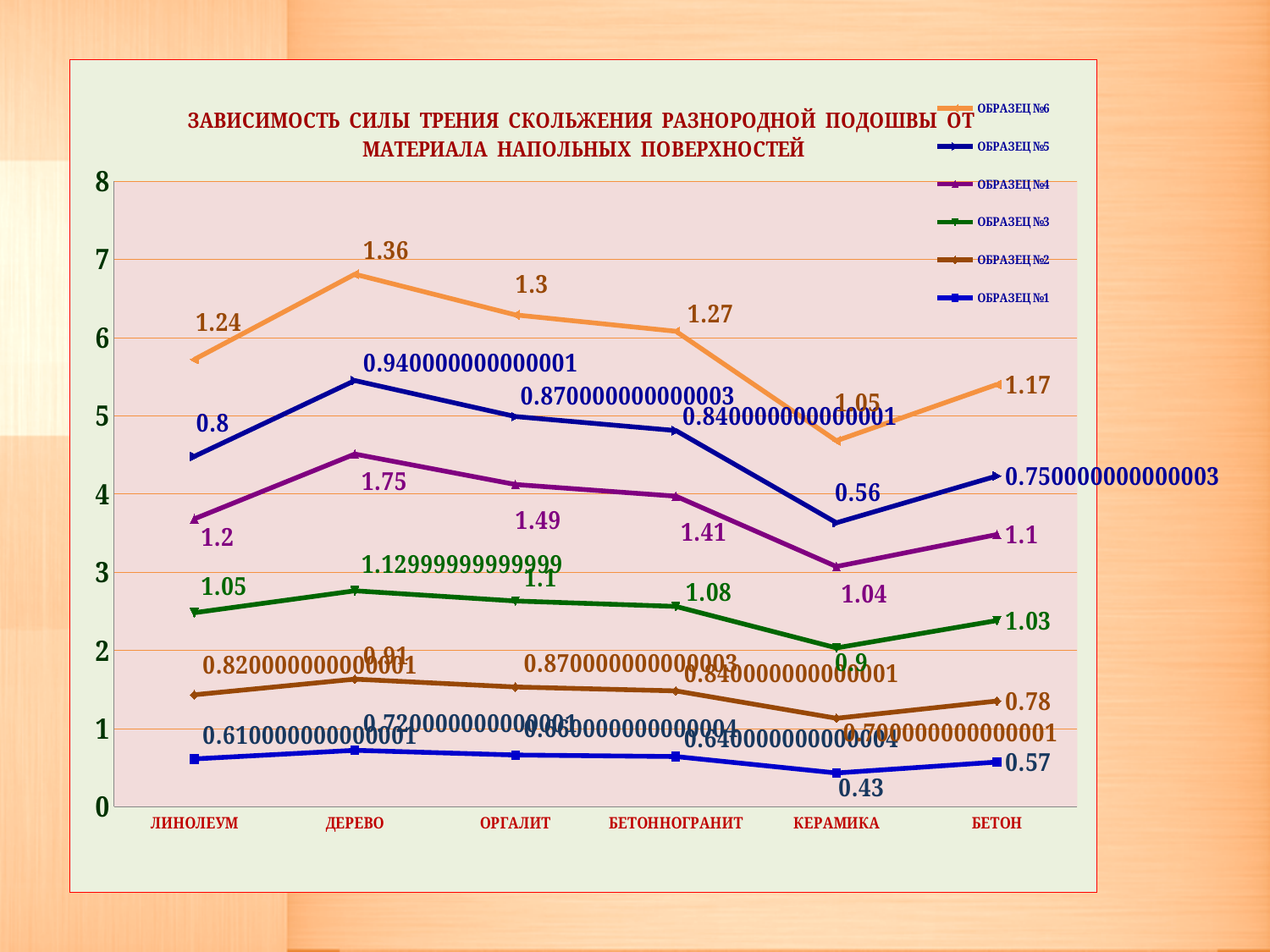
What is the value for ОБРАЗЕЦ №4 at ДЕРЕВО? 1.75 What is the value for ОБРАЗЕЦ №1 at КЕРАМИКА? 0.43 For ОБРАЗЕЦ №6, which category has the highest value? ДЕРЕВО For ОБРАЗЕЦ №4, which is larger: the value at ДЕРЕВО or at ОРГАЛИТ? ДЕРЕВО What is the value for ОБРАЗЕЦ №3 at БЕТОН? 1.03 For ОБРАЗЕЦ №6, which category has the lowest value? КЕРАМИКА What is the difference between the ОБРАЗЕЦ №6 values at ДЕРЕВО and КЕРАМИКА? 0.31 What is the value for ОБРАЗЕЦ №6 at ДЕРЕВО? 1.36 What kind of chart is shown on the slide? line chart How many floor material categories are shown on the x axis? 6 What is the value for ОБРАЗЕЦ №5 at КЕРАМИКА? 0.56 How many series does the legend list? 6